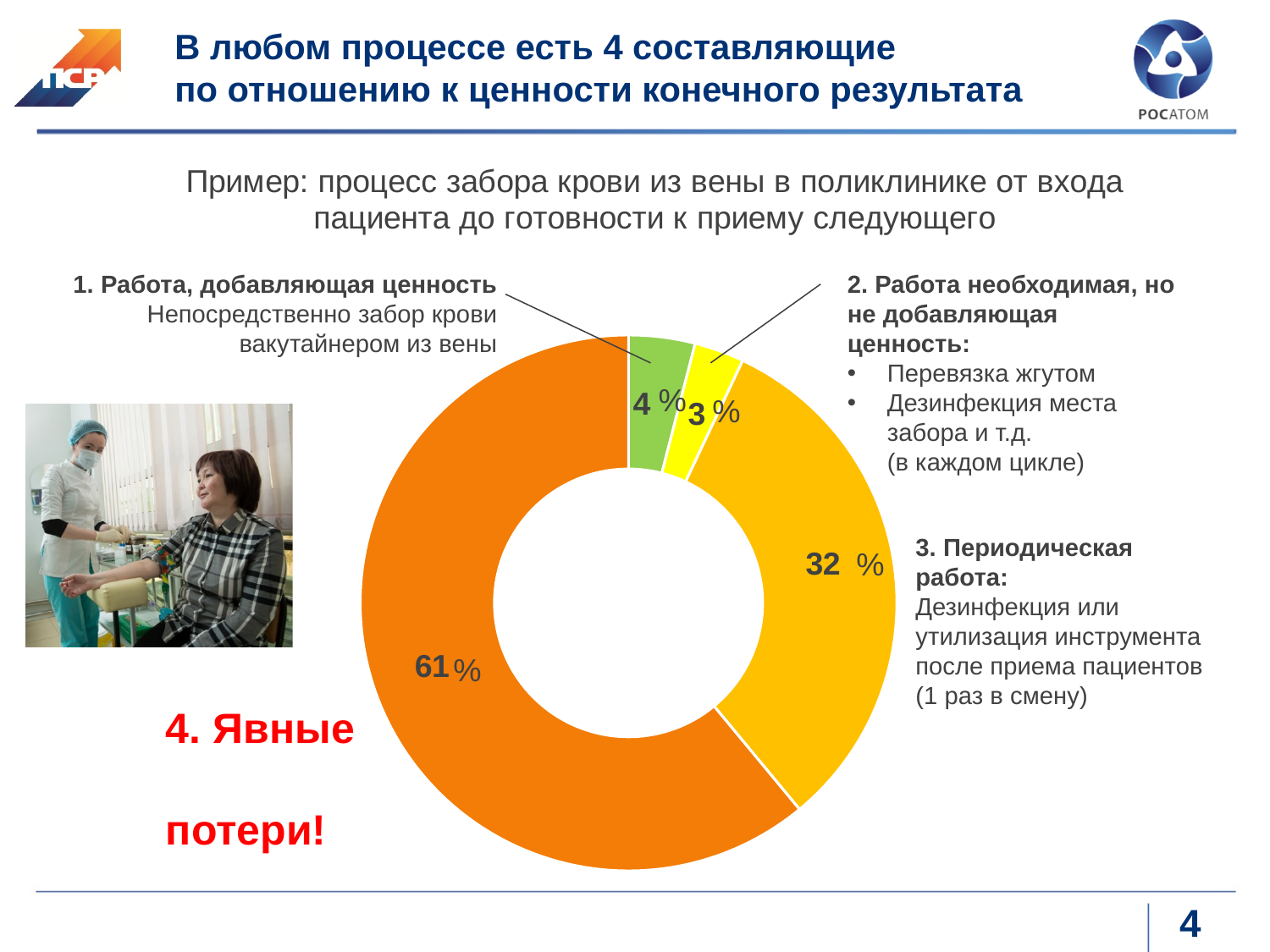
Which component has the smallest share of the chart? Работа необходимая, но не добавляющая ценность (3%) Which component has the largest share of the chart? Явные потери (61%) What is the combined share of the two smallest segments (4% and 3%)? 7% Which is larger: the share for "Работа, добавляющая ценность" or for "Работа необходимая, но не добавляющая ценность"? Работа, добавляющая ценность What percentage is shown for "Явные потери"? 61% What is the difference in percentage points between "Явные потери" and "Периодическая работа"? 29 percentage points What percentage is shown for "Периодическая работа"? 32% What percentage is shown for "Работа необходимая, но не добавляющая ценность"? 3% What percentage is shown for "Работа, добавляющая ценность" (work adding value)? 4% How many segments does the doughnut chart have? 4 What colour is the segment representing "Явные потери"? Orange What kind of chart is shown on the slide? Doughnut (pie) chart